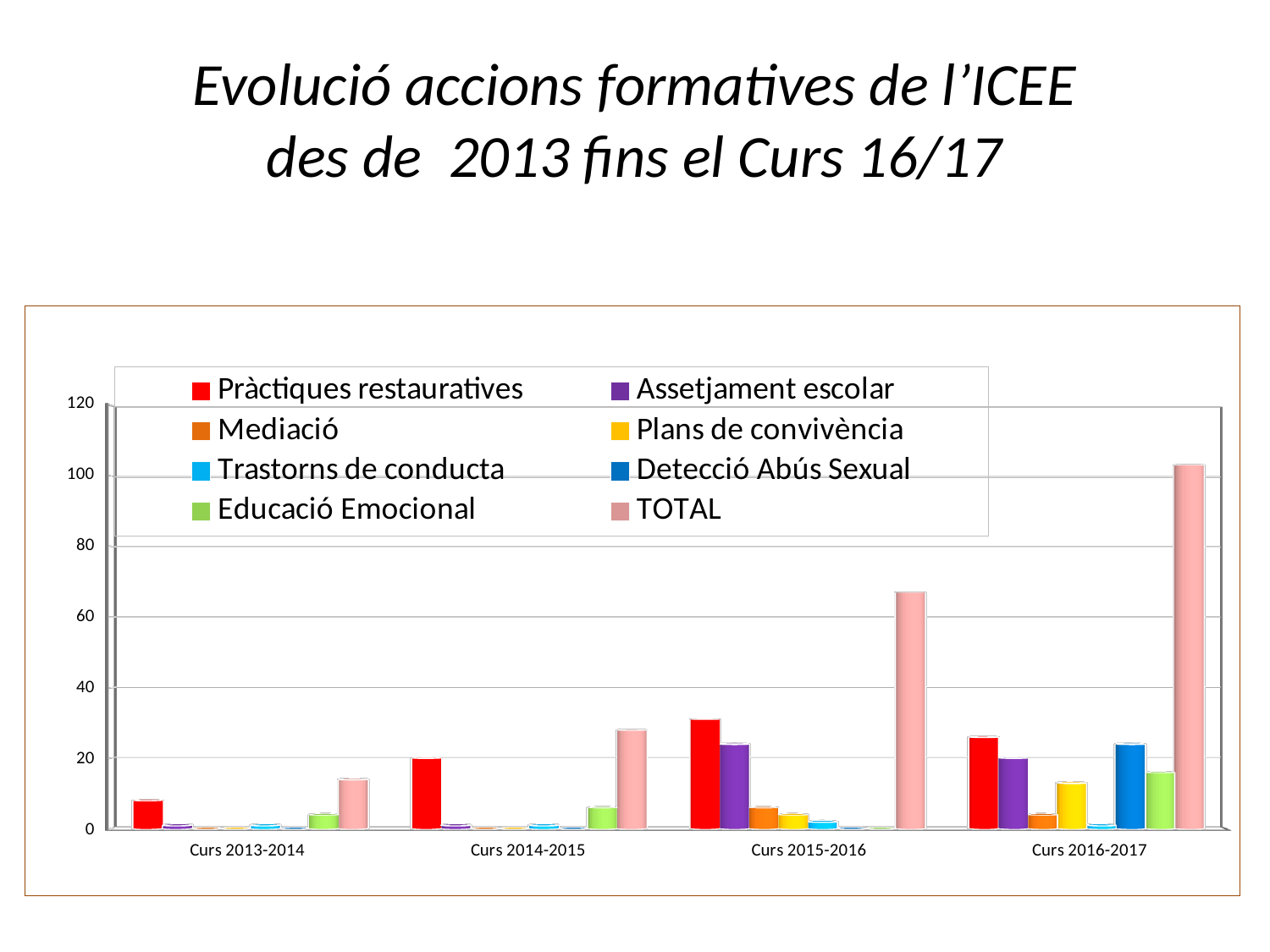
How many school-year categories are shown on the x axis? 4 Does the TOTAL series rise or fall from Curs 2013-2014 to Curs 2016-2017? rise Is the TOTAL value for Curs 2015-2016 greater or less than 60? greater What kind of chart is shown on the slide? bar chart What colour represents the TOTAL series in the legend? pink Is the TOTAL value for Curs 2016-2017 greater or less than 100? greater Is the TOTAL value for Curs 2013-2014 greater or less than 20? less Which is larger in Curs 2016-2017: Detecció Abús Sexual or Plans de convivència? Detecció Abús Sexual In which school year is the TOTAL bar the lowest? Curs 2013-2014 In which school year is the TOTAL bar the highest? Curs 2016-2017 How many series does the legend list? 8 Which is larger in Curs 2015-2016: Pràctiques restauratives or Mediació? Pràctiques restauratives